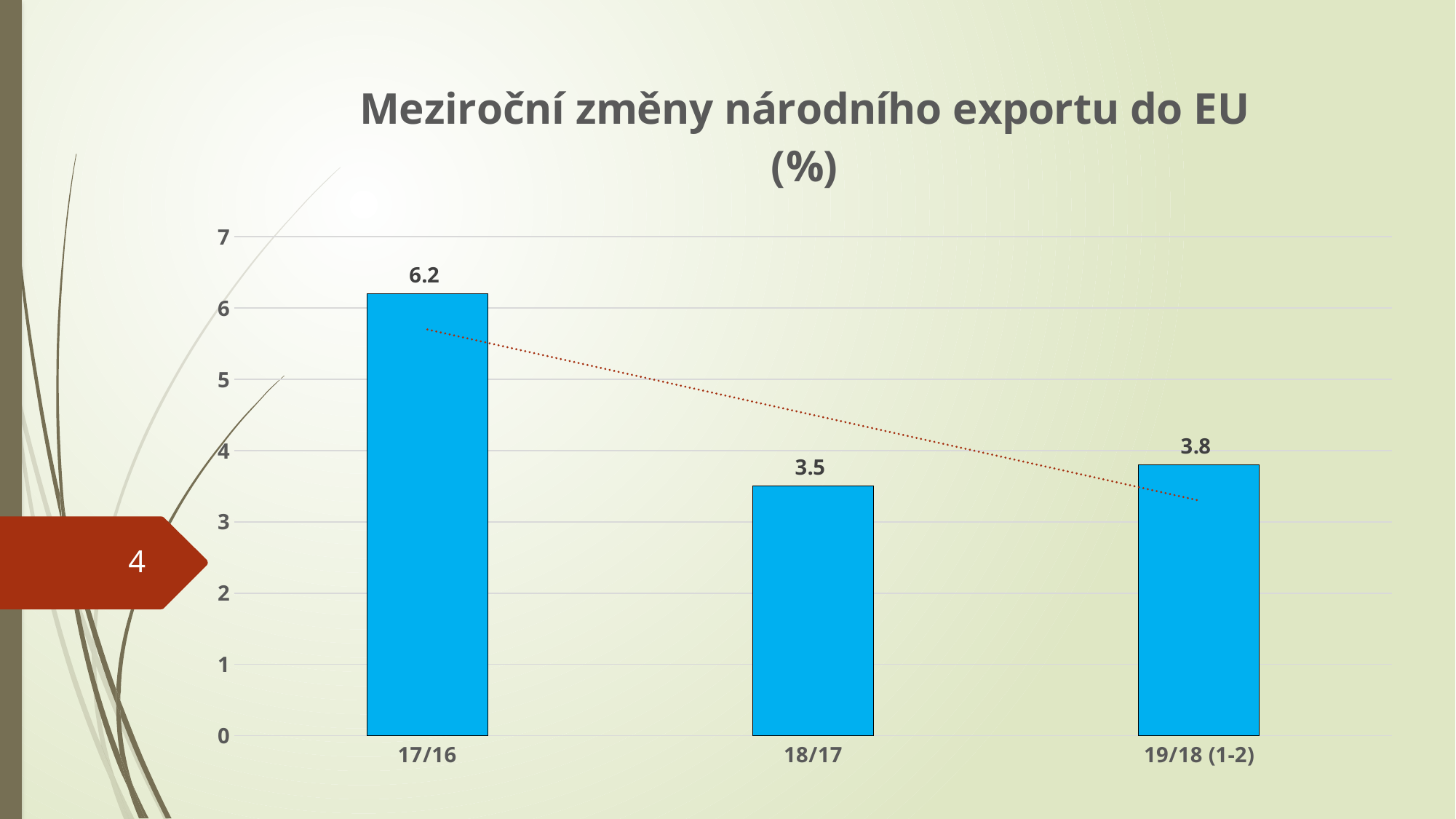
Which category has the lowest value? 18/17 What is the value for 18/17? 3.5 How many categories are shown on the x axis? 3 What is the value for 19/18 (1-2)? 3.8 Is the value for 18/17 greater or less than 4? less Which category has the highest value? 17/16 What is the difference between the values for 19/18 (1-2) and 18/17? 0.3 Which is larger, the value for 17/16 or the value for 19/18 (1-2)? 17/16 What is the difference between the values for 17/16 and 18/17? 2.7 What kind of chart is shown on the slide? bar chart What is the title of the chart? Meziroční změny národního exportu do EU (%) What is the value for 17/16? 6.2